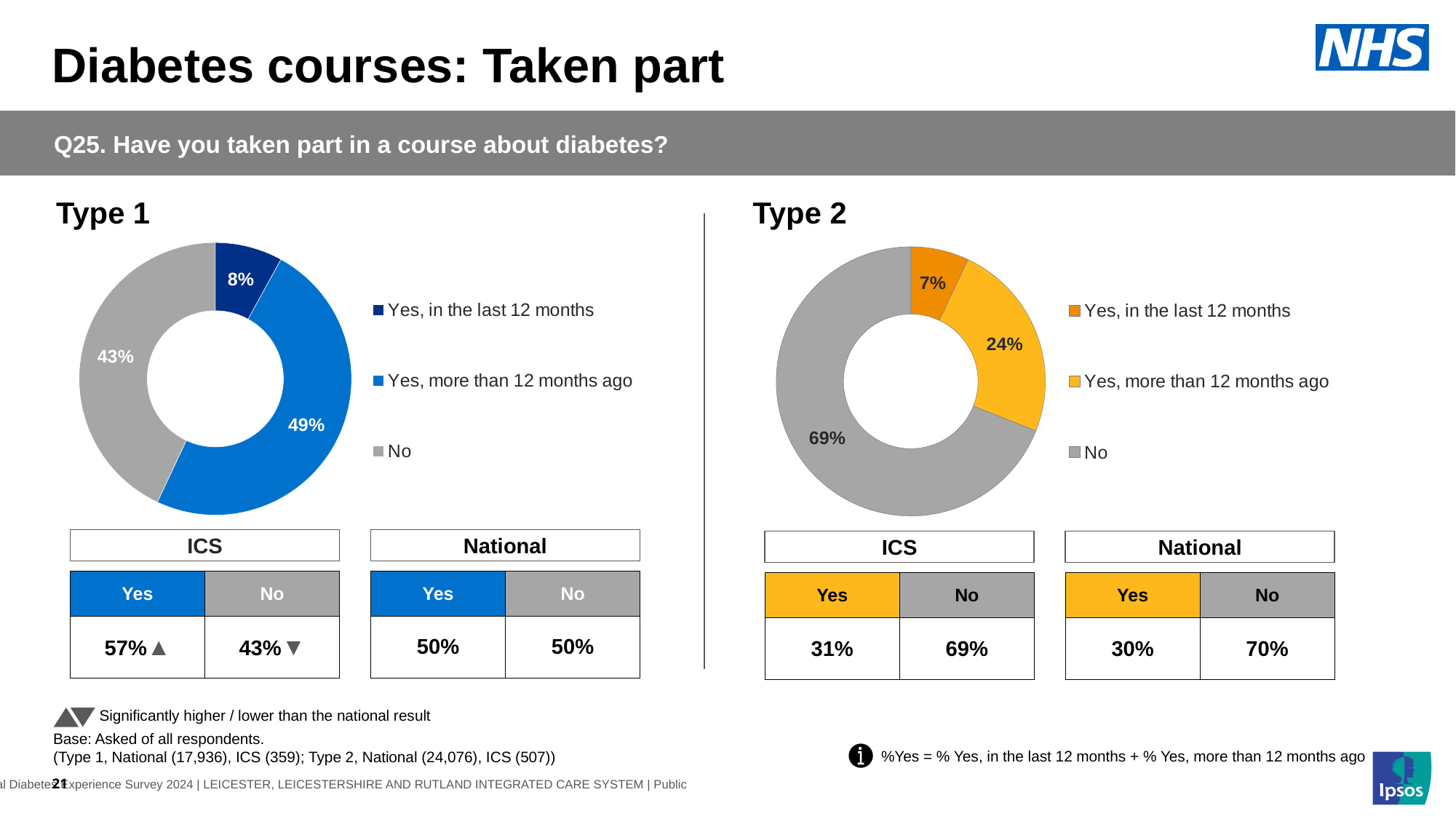
In the Type 1 chart, what is the difference between the 'Yes, more than 12 months ago' share and the 'Yes, in the last 12 months' share? 41 percentage points In the Type 1 chart, what colour represents 'No'? Grey In the Type 1 chart, which category has the largest share? Yes, more than 12 months ago In the Type 2 chart, which category has the smallest share? Yes, in the last 12 months In the Type 2 chart, which is larger: 'No' or 'Yes, more than 12 months ago'? No In the Type 2 chart, what percentage of respondents said 'Yes, more than 12 months ago'? 24% How many categories does the Type 2 chart show? 3 In the Type 2 chart, what percentage of respondents said 'No'? 69% What kind of chart is used for Type 1? Doughnut (pie) chart In the Type 1 chart, what percentage of respondents said 'Yes, in the last 12 months'? 8% In the Type 1 chart, what percentage of respondents said 'No'? 43% In the Type 2 chart, what colour represents 'Yes, in the last 12 months'? Dark orange